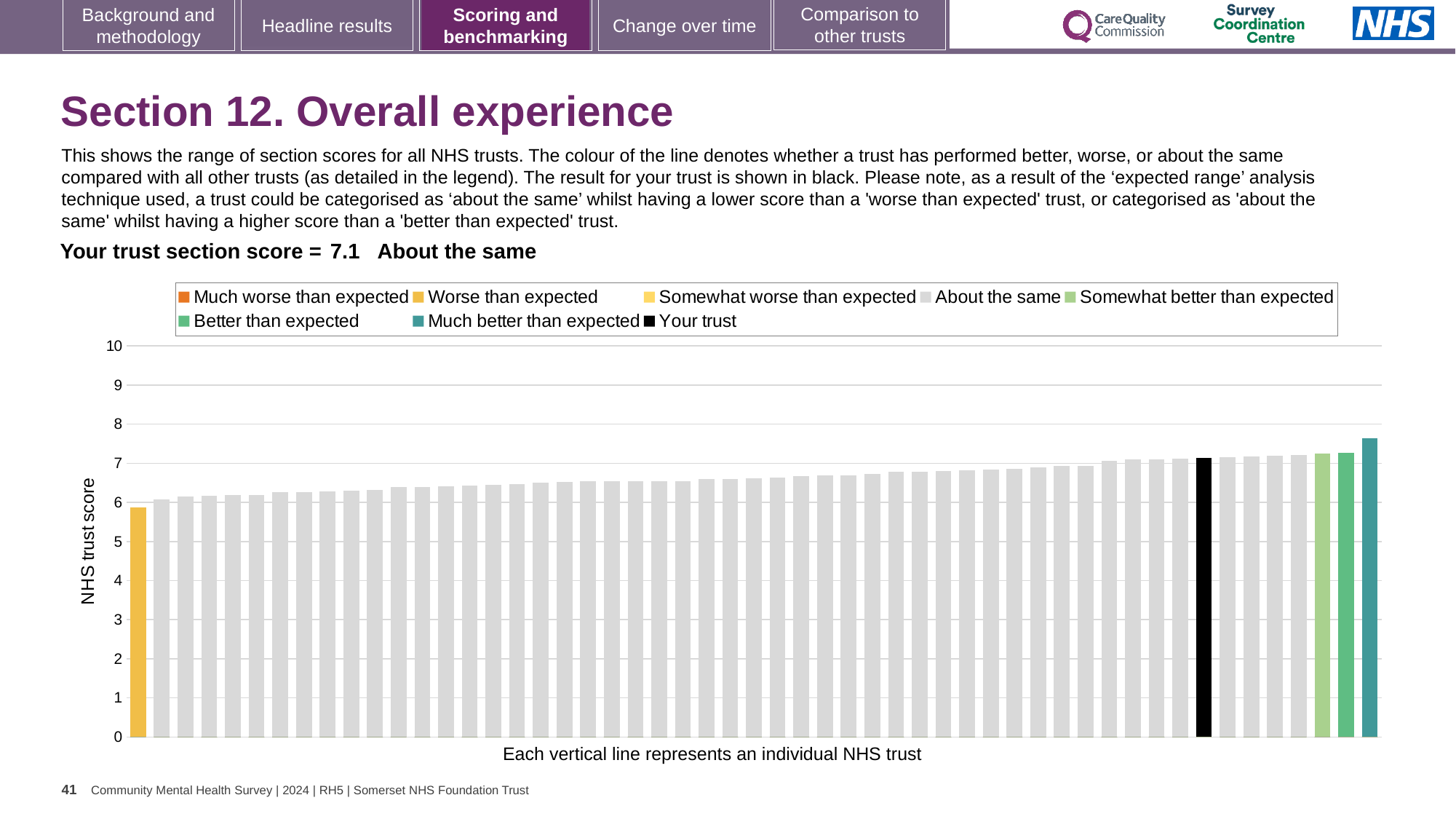
What is the section score for your trust shown on the slide? 7.1 What kind of chart is shown on the slide? bar chart Which benchmarking category is your trust placed in for this section? About the same Which legend category does the tallest bar belong to? Much better than expected Is your trust's bar (black) taller or shorter than the rightmost teal bar? shorter Is the value of the shortest bar (leftmost) greater or less than 5? greater What is the label on the vertical axis of the chart? NHS trust score Is the value of the shortest bar (leftmost) greater or less than 7? less What colour is the bar representing your trust? black How many entries does the chart legend list? 8 Is the value of the tallest bar (rightmost) greater or less than 7? greater Do the bar values rise or fall from left to right along the x axis? rise